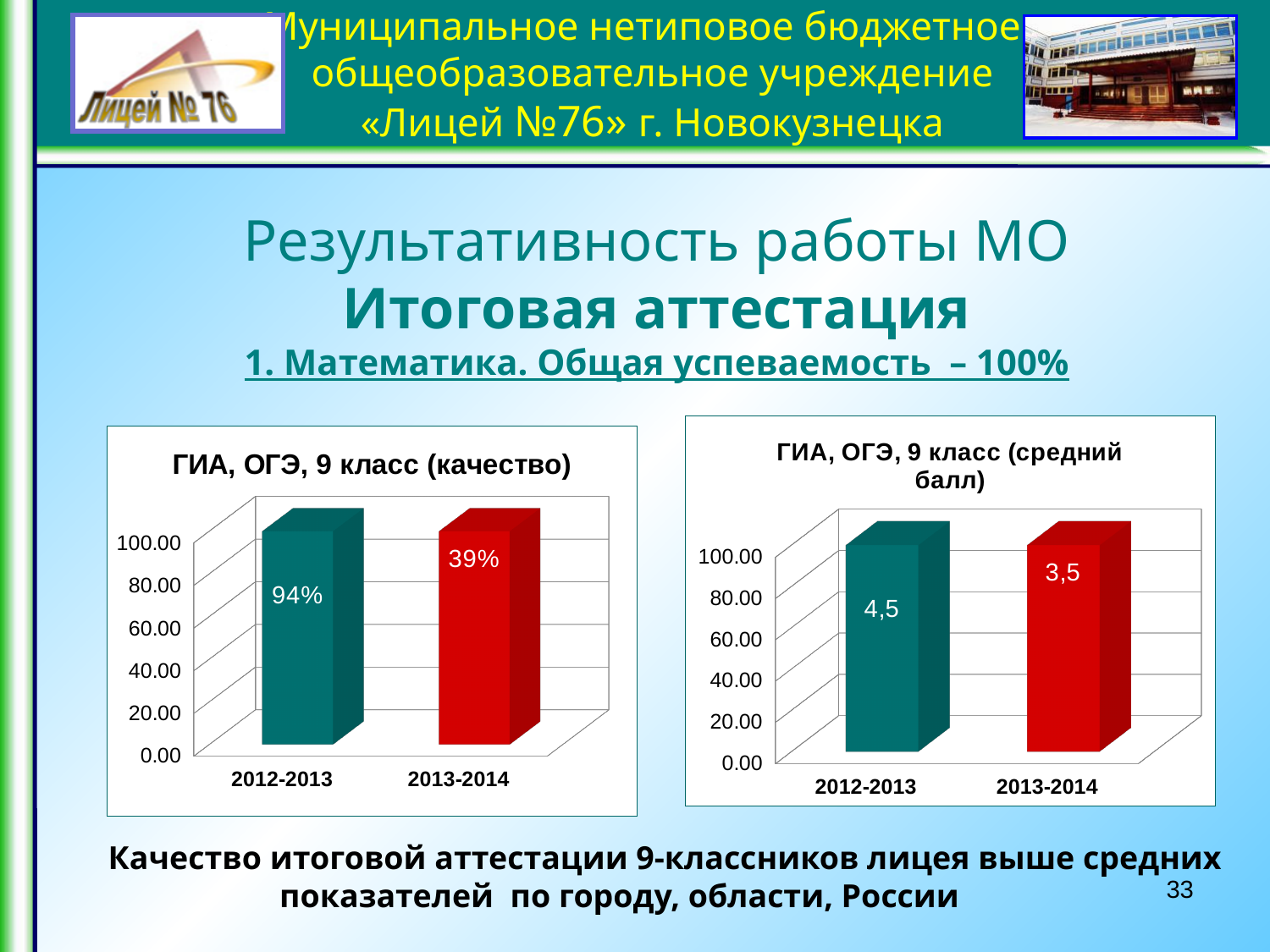
In the left chart (ГИА, ОГЭ, 9 класс (качество)), what is the value labelled for 2012-2013? 94% In the right chart (ГИА, ОГЭ, 9 класс (средний балл)), which year has the higher labelled value, 2012-2013 or 2013-2014? 2012-2013 In the left chart (ГИА, ОГЭ, 9 класс (качество)), what colour is the bar for 2013-2014? Red In the left chart (ГИА, ОГЭ, 9 класс (качество)), what is the difference between the labelled values for 2012-2013 and 2013-2014? 55% In the left chart (ГИА, ОГЭ, 9 класс (качество)), what is the value labelled for 2013-2014? 39% In the right chart (ГИА, ОГЭ, 9 класс (средний балл)), what is the value labelled for 2012-2013? 4,5 In the left chart (ГИА, ОГЭ, 9 класс (качество)), which year has the lower labelled value, 2012-2013 or 2013-2014? 2013-2014 How many bars are shown in the right chart (ГИА, ОГЭ, 9 класс (средний балл))? 2 What is the title of the right chart on the slide? ГИА, ОГЭ, 9 класс (средний балл) What kind of chart is the left chart (ГИА, ОГЭ, 9 класс (качество))? Bar chart How many categories (school years) are shown in the left chart (ГИА, ОГЭ, 9 класс (качество))? 2 In the right chart (ГИА, ОГЭ, 9 класс (средний балл)), what is the value labelled for 2013-2014? 3,5